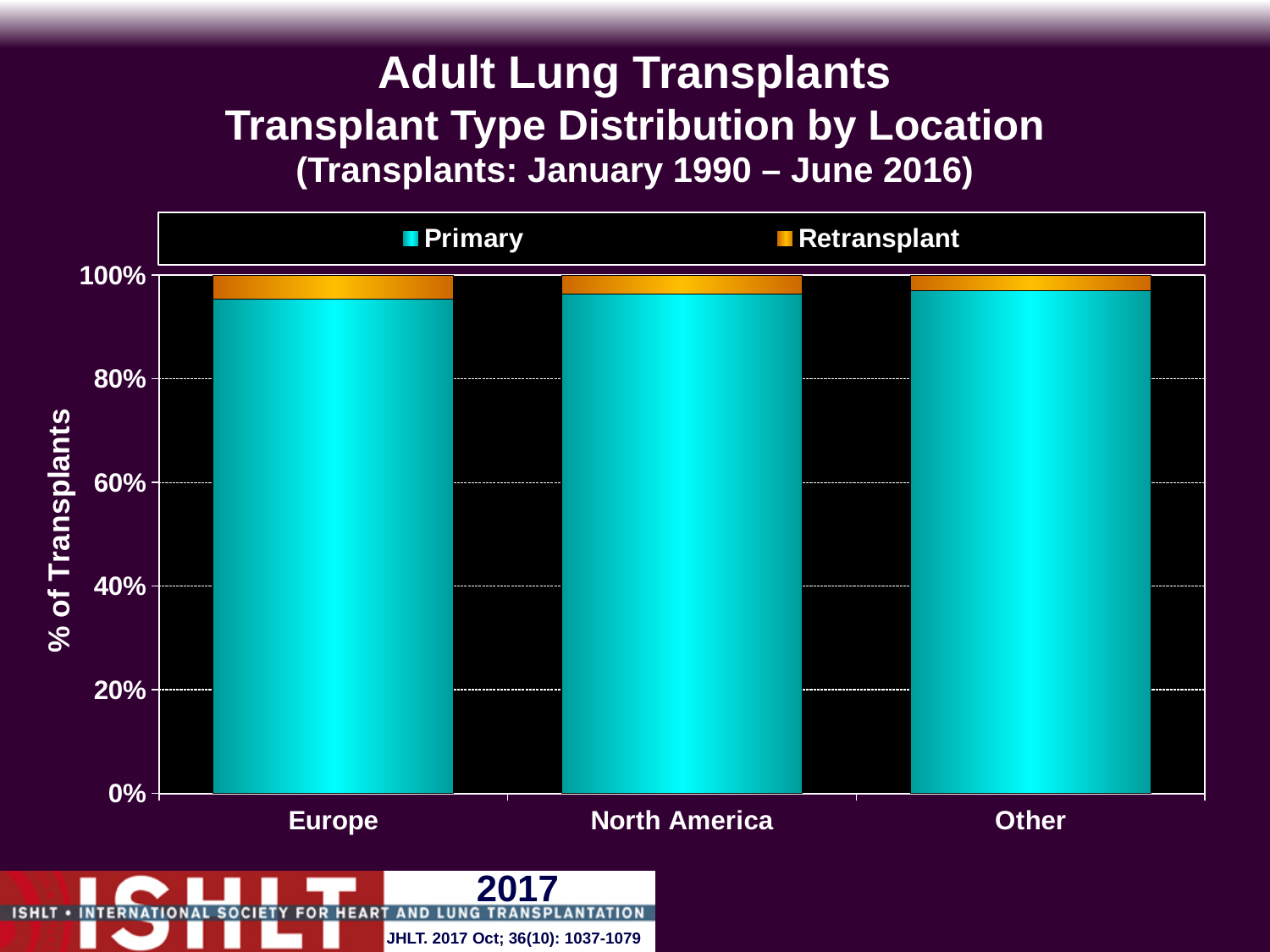
Is the Primary value for Europe greater or less than 80%? greater Is the Retransplant value for North America greater or less than 20%? less For North America, which series has the smaller share: Primary or Retransplant? Retransplant What is the label on the y axis of the chart? % of Transplants What is the total height of the stacked bar for Other? 100% How many locations are shown on the x axis of the chart? 3 Is the Primary value for Other greater or less than 60%? greater How many series does the chart's legend list? 2 For Europe, which is larger: the Primary share or the Retransplant share? Primary Which location is shown in the middle position on the x axis? North America What are the two series listed in the chart's legend? Primary and Retransplant What kind of chart is shown on the slide? Stacked bar chart